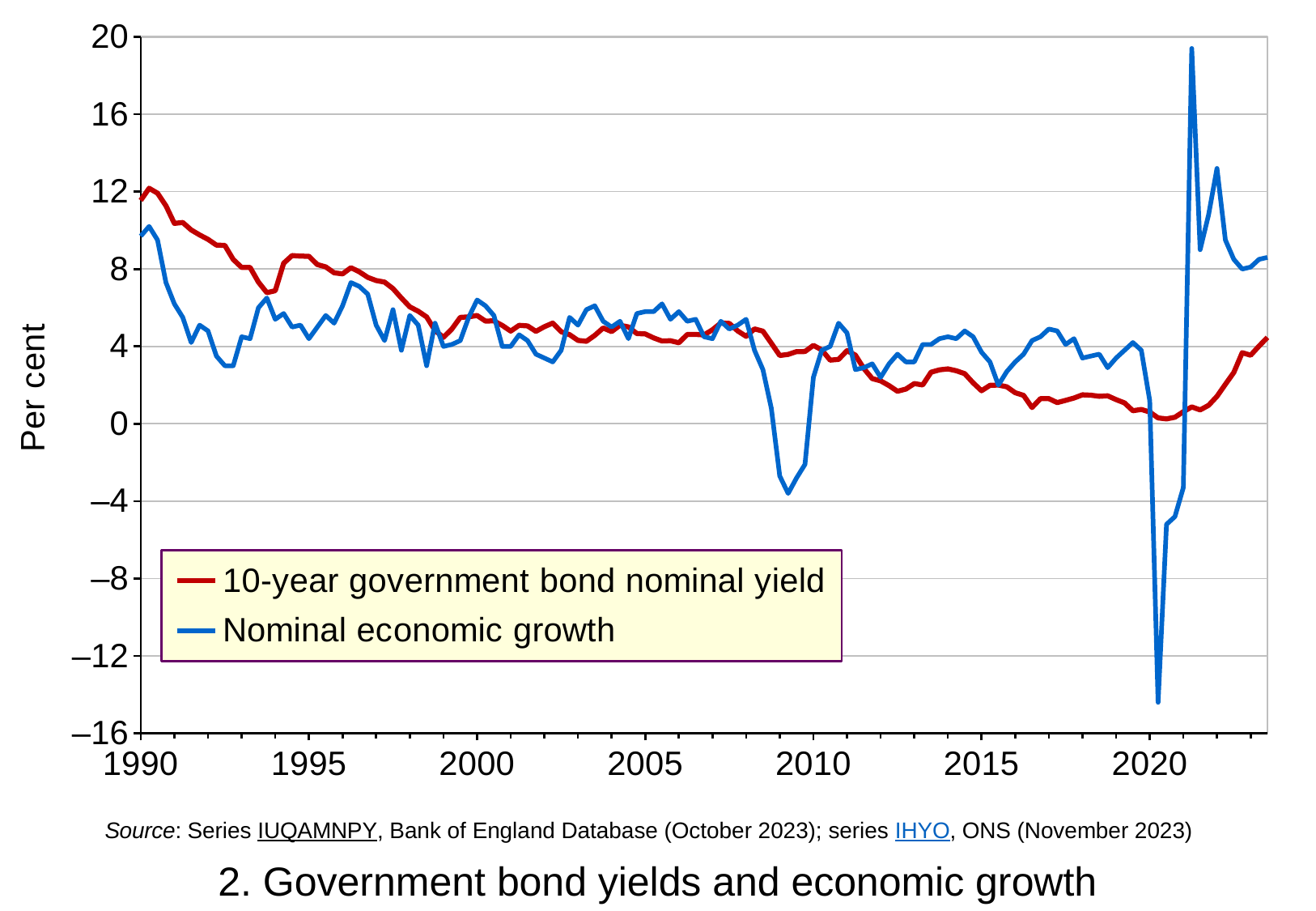
Is the value for Nominal economic growth at its lowest point around 2020 greater or less than -12? less What kind of chart is shown on the slide? line chart Is the value for the 10-year government bond nominal yield in 2020 greater or less than 4? less Which series reaches the highest value anywhere on the chart? Nominal economic growth Is the value for Nominal economic growth at its low point around 2009 greater or less than 0? less What is the label on the vertical axis? Per cent How many series does the legend list? 2 What is the title of the chart? 2. Government bond yields and economic growth Does the 10-year government bond nominal yield generally rise or fall from 1990 to 2020? fall Around 2009, which series has the higher value: the 10-year government bond nominal yield or Nominal economic growth? 10-year government bond nominal yield